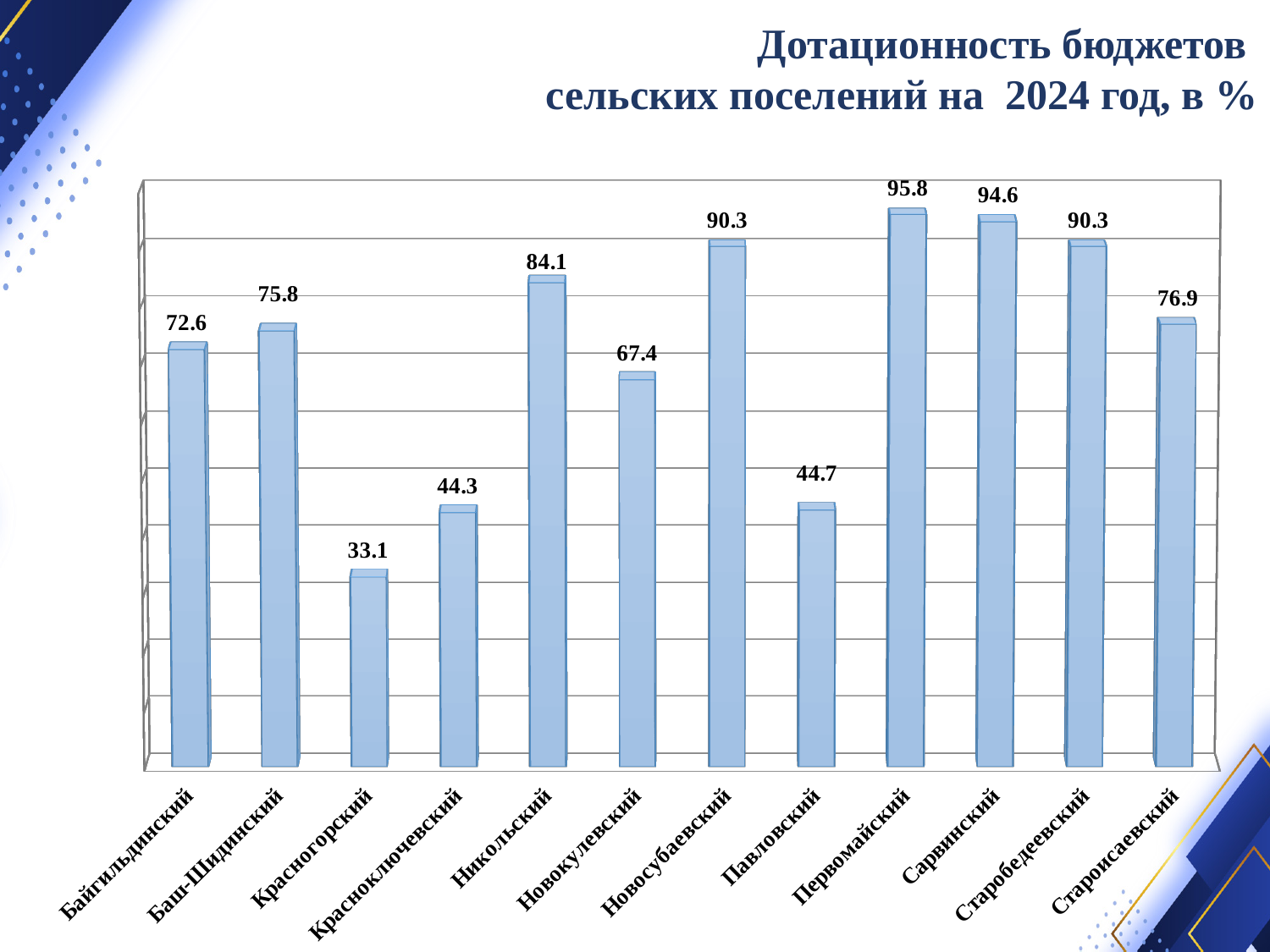
What is the value for Староисаевский? 76.9 Which is larger, the value for Павловский or the value for Красноключевский? Павловский What is the difference between the values for Никольский and Баш-Шидинский? 8.3 What is the value for Красноключевский? 44.3 What is the value for Новокулевский? 67.4 How many categories are shown on the chart? 12 What kind of chart is shown on the slide? Bar chart What is the value for Байгильдинский? 72.6 Which category has the highest value? Первомайский What is the title of the chart? Дотационность бюджетов сельских поселений на 2024 год, в % What is the difference between the values for Первомайский and Красногорский? 62.7 Which category has the lowest value? Красногорский